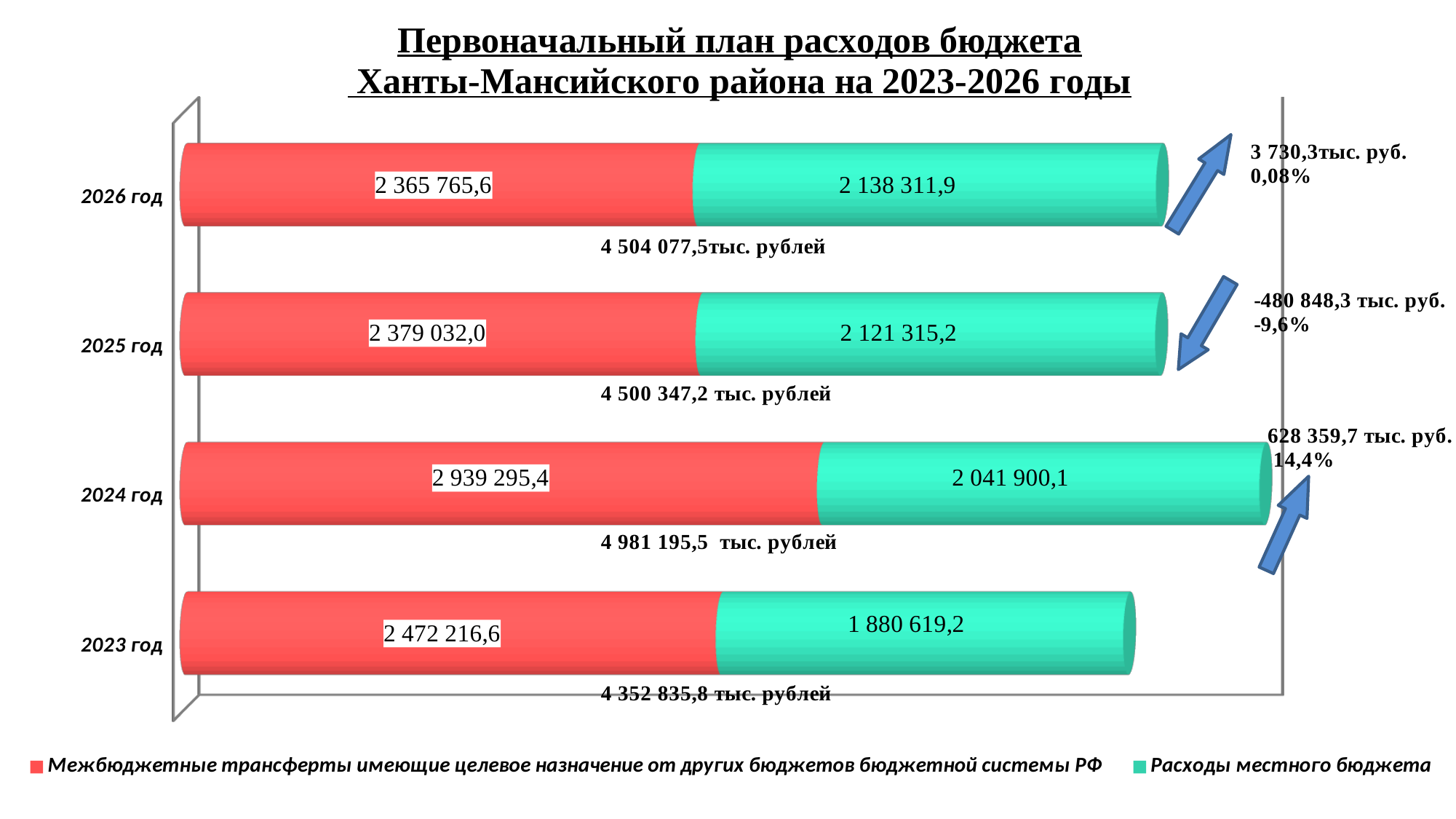
What is the value of «Расходы местного бюджета» for 2023 год? 1 880 619,2 What is the total planned expenditure shown for 2026 год? 4 504 077,5 тыс. рублей What is the total planned expenditure shown for 2025 год? 4 500 347,2 тыс. рублей What is the value of «Межбюджетные трансферты имеющие целевое назначение от других бюджетов бюджетной системы РФ» for 2024 год? 2 939 295,4 Which year has the highest total planned expenditure? 2024 год Do the values of «Расходы местного бюджета» rise or fall from 2023 год to 2026 год? Rise How many series does the legend list? 2 What kind of chart is shown on the slide? Stacked bar chart What is the difference between the «Межбюджетные трансферты» values for 2024 год and 2023 год? 467 078,8 Which is larger: «Расходы местного бюджета» for 2024 год or for 2023 год? 2024 год Which year has the lowest value of «Расходы местного бюджета»? 2023 год How many years are shown on the chart? 4